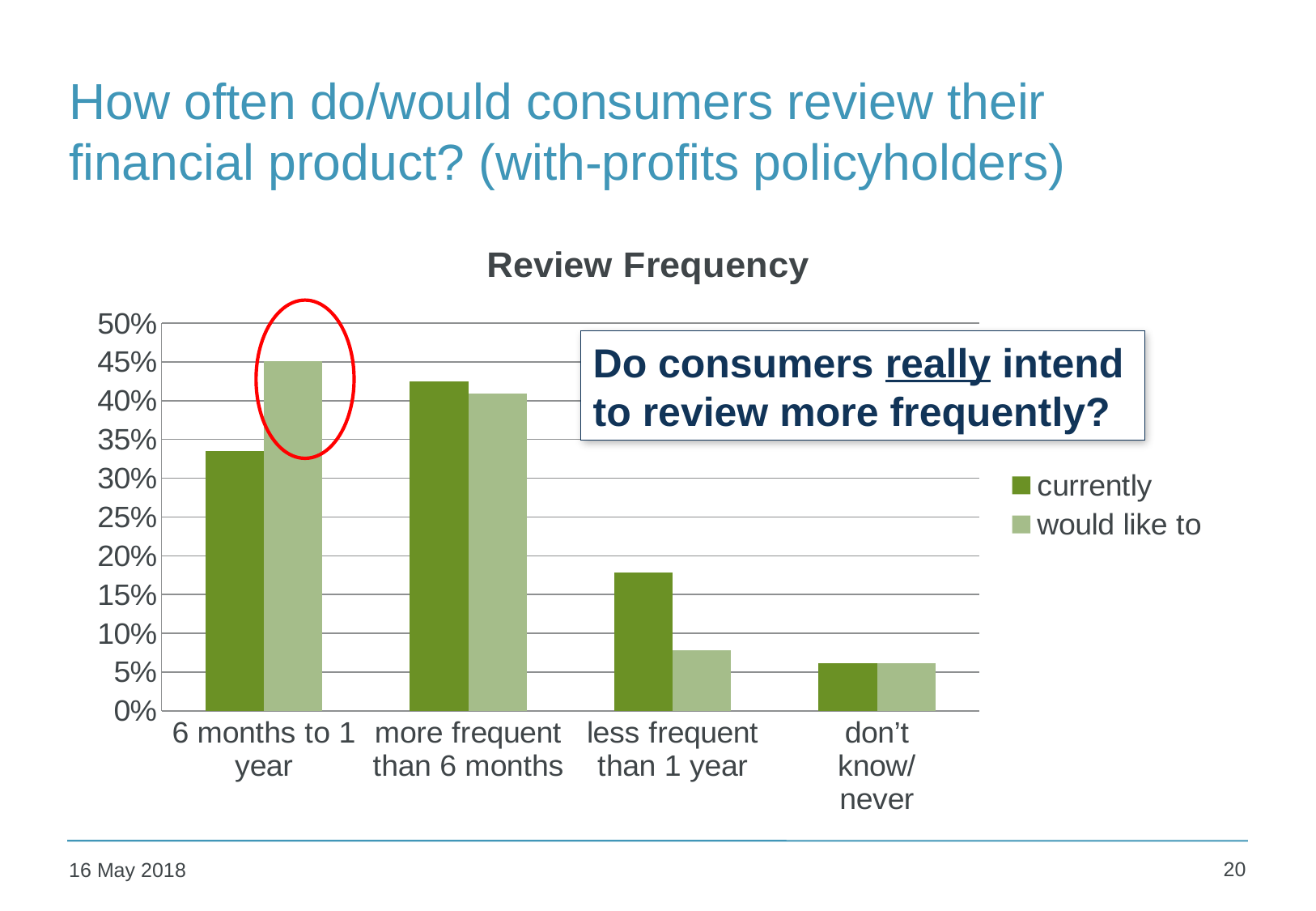
Is the "would like to" value for "less frequent than 1 year" greater or less than 10%? less For "6 months to 1 year", which is larger: the "currently" value or the "would like to" value? would like to How many series does the legend of the Review Frequency chart list? 2 What type of chart is shown under the title "Review Frequency"? bar chart Which category has the highest "currently" value in the Review Frequency chart? more frequent than 6 months Is the "currently" value for "more frequent than 6 months" greater or less than 40%? greater Which category has the lowest "currently" value in the Review Frequency chart? don't know/never For "less frequent than 1 year", which is larger: the "currently" value or the "would like to" value? currently How many categories are shown on the x axis of the Review Frequency chart? 4 Is the "currently" value for "6 months to 1 year" greater or less than 30%? greater Which category has the highest "would like to" value in the Review Frequency chart? 6 months to 1 year What are the two legend entries in the Review Frequency chart? currently, would like to